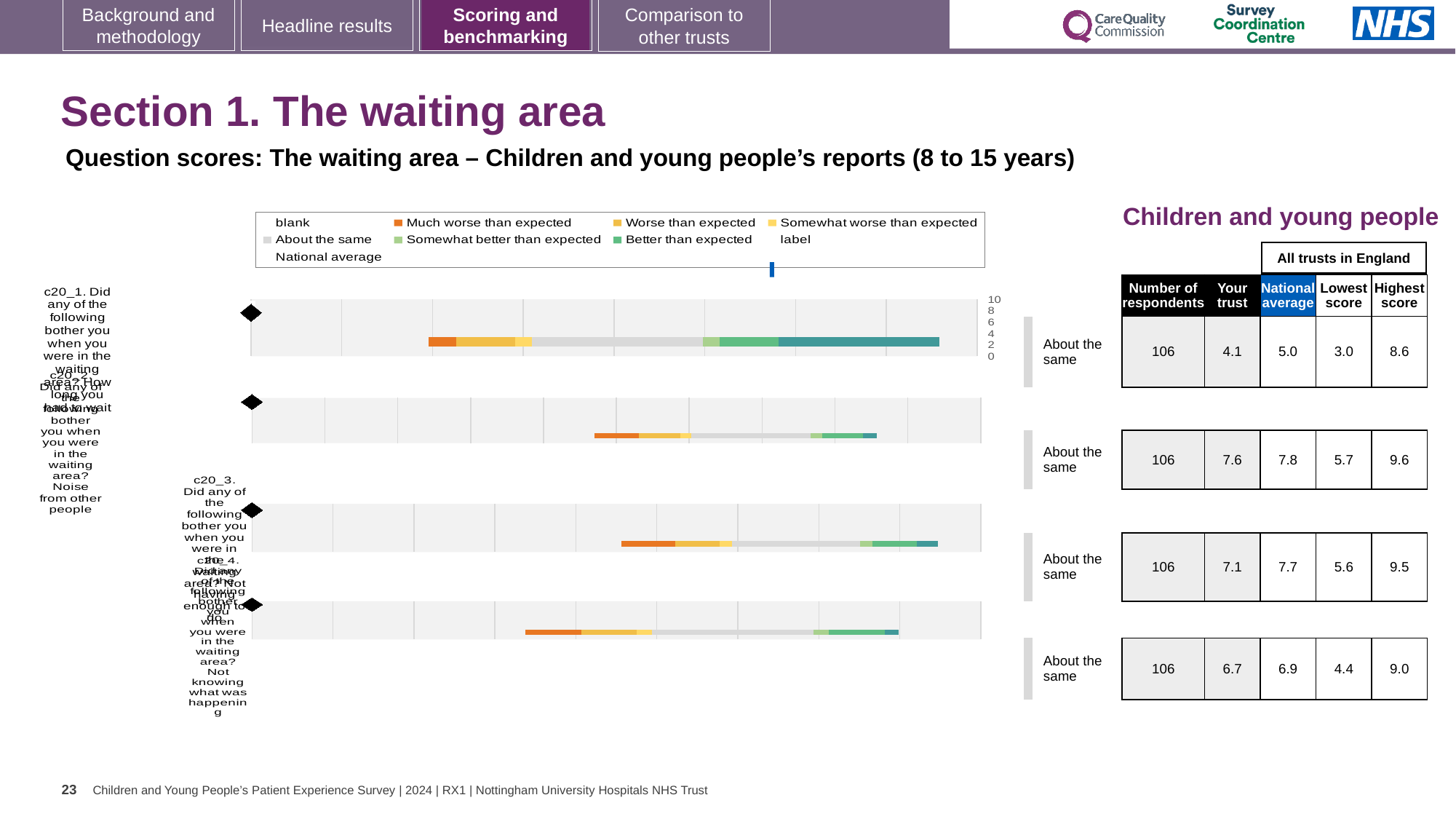
According to the table beside the third chart (c20_3), what is the highest score among all trusts in England? 9.5 According to the table beside the second chart (c20_2), what is the national average score? 7.8 How many entries does the legend above the charts list? 9 In the legend, what colour represents 'Much worse than expected'? orange What rating label is printed to the right of the first chart (c20_1)? About the same What rating label is printed to the right of the fourth chart (c20_4)? About the same What kind of chart is used for the four question-score charts on the slide? bar chart According to the table, which chart's question has the lowest 'Your trust' score? c20_1 According to the table beside the fourth chart (c20_4), what is the difference between the national average (6.9) and the 'Your trust' score (6.7)? 0.2 How many separate question-score bar charts are shown on the slide? 4 According to the table beside the first chart (c20_1), what is the 'Your trust' score? 4.1 What is the highest tick value shown on the axis of the first chart? 10